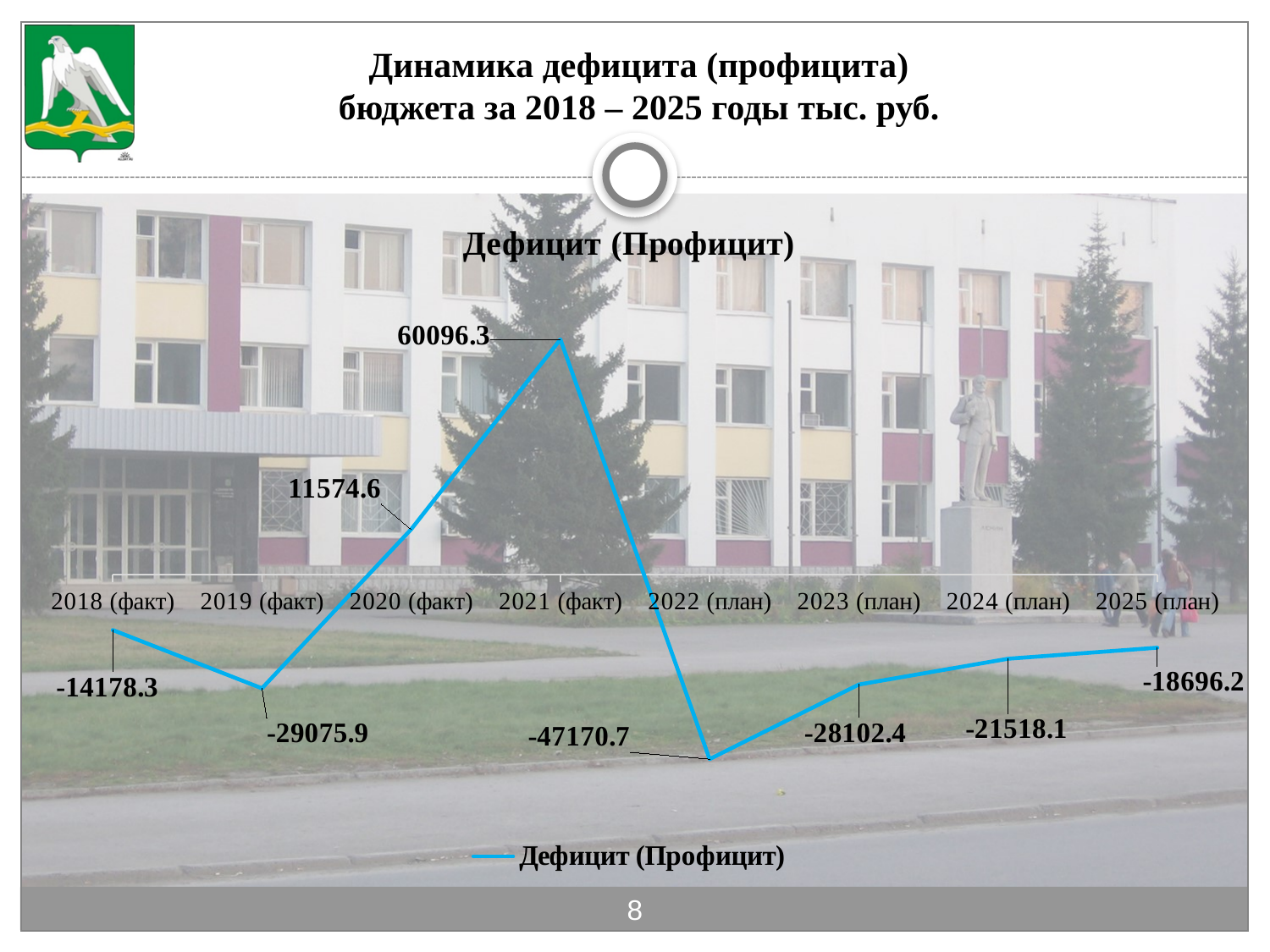
How many years are plotted in the chart? 8 What kind of chart is shown on the slide? Line chart What is the difference between the values for 2025 (план) and 2024 (план)? 2821.9 What is the difference between the values for 2021 (факт) and 2020 (факт)? 48521.7 What is the value for 2021 (факт) in the chart? 60096.3 What is the value for 2025 (план) in the chart? -18696.2 What is the value for 2022 (план) in the chart? -47170.7 Which is larger, the value for 2019 (факт) or the value for 2023 (план)? 2023 (план) Which year has the lowest value in the chart? 2022 (план) What is the name of the series shown in the chart legend? Дефицит (Профицит) Which year has the highest value in the chart? 2021 (факт) What is the value for 2018 (факт) in the chart? -14178.3